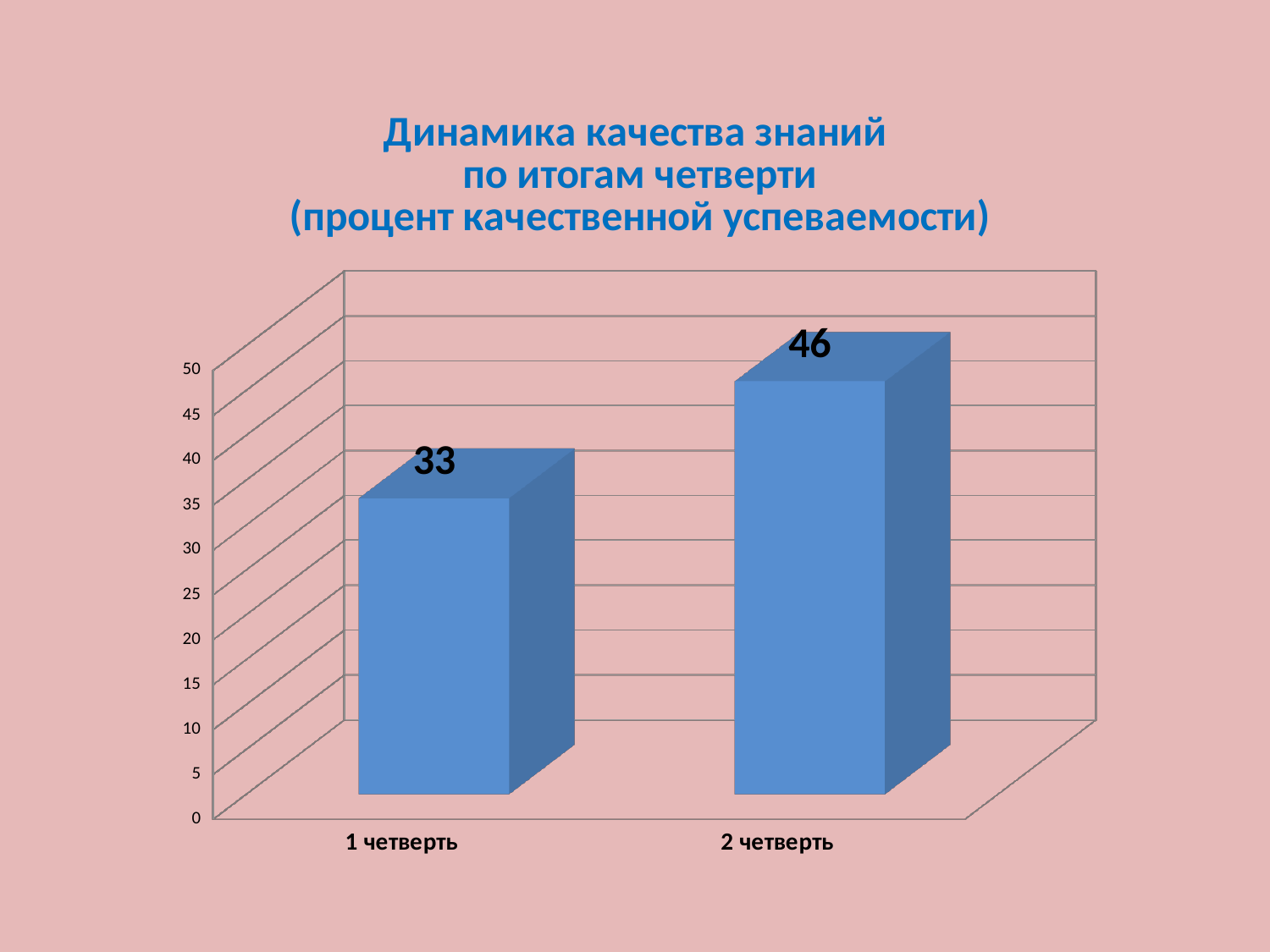
Do the values rise or fall from 1 четверть to 2 четверть? rise Is the value for 2 четверть greater or less than 40? greater What is the difference between the values for 2 четверть and 1 четверть? 13 What is the value for 2 четверть? 46 Which category has the lowest value? 1 четверть What is the first line of the chart's title? Динамика качества знаний What is the value for 1 четверть? 33 Which category has the highest value? 2 четверть Which is larger, the value for 1 четверть or the value for 2 четверть? 2 четверть What kind of chart is shown on the slide? bar chart Is the value for 1 четверть greater or less than 35? less How many categories are shown on the x axis? 2